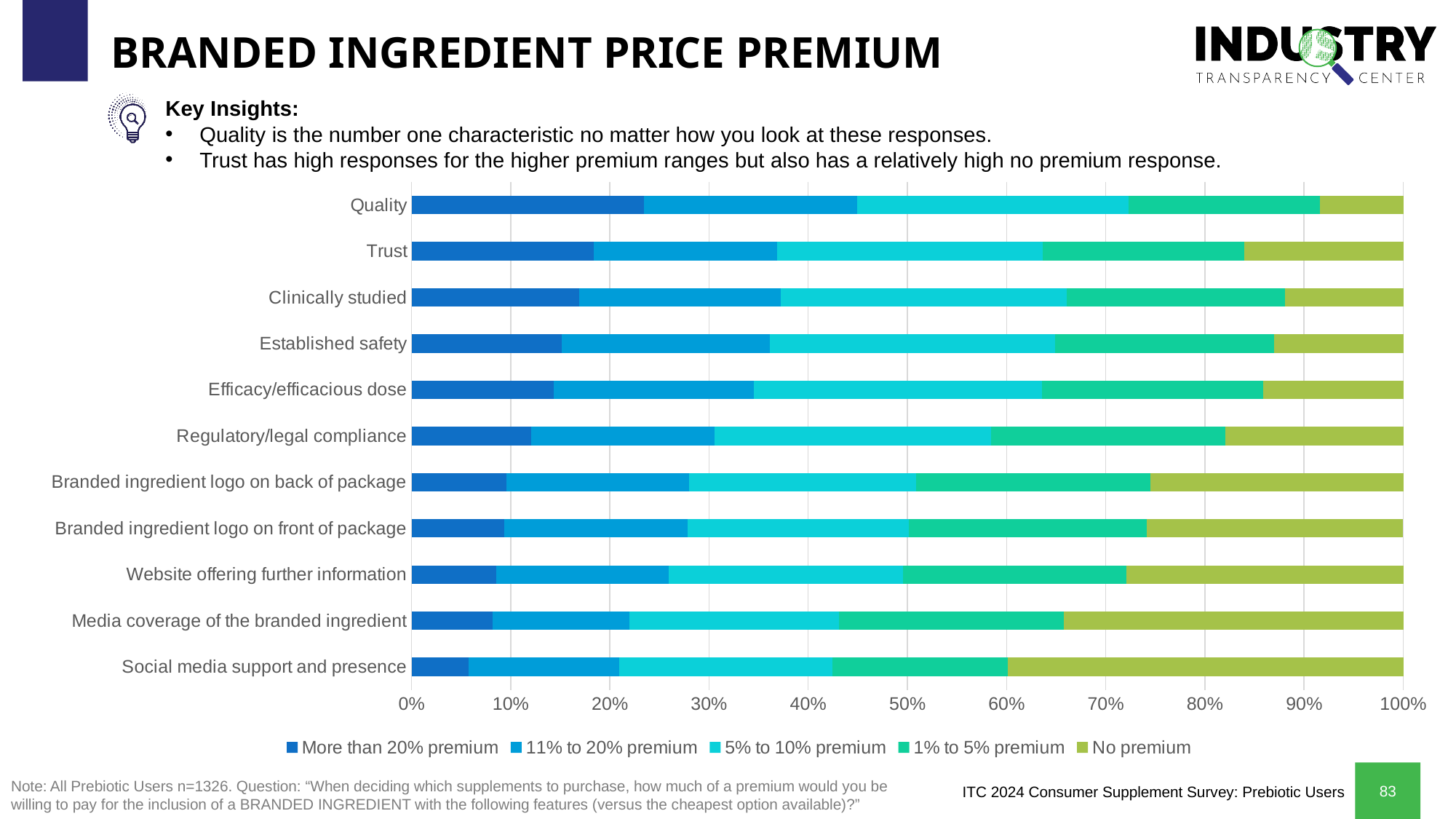
Which category has the largest 'No premium' segment? Social media support and presence Which category has the smallest 'No premium' segment? Quality Moving down the categories from Quality to Social media support and presence, does the 'More than 20% premium' segment generally rise or fall? Fall What kind of chart is shown on the slide? Stacked bar chart Which category has the largest 'More than 20% premium' segment? Quality What is the title of the slide containing the chart? BRANDED INGREDIENT PRICE PREMIUM Which has a larger 'More than 20% premium' segment, Quality or Trust? Quality Is the 'More than 20% premium' value for Social media support and presence greater or less than 10%? less Is the 'More than 20% premium' value for Quality greater or less than 20%? greater Which has a larger 'No premium' segment, Social media support and presence or Quality? Social media support and presence How many categories (features) are plotted on the chart? 11 How many series does the legend list? 5